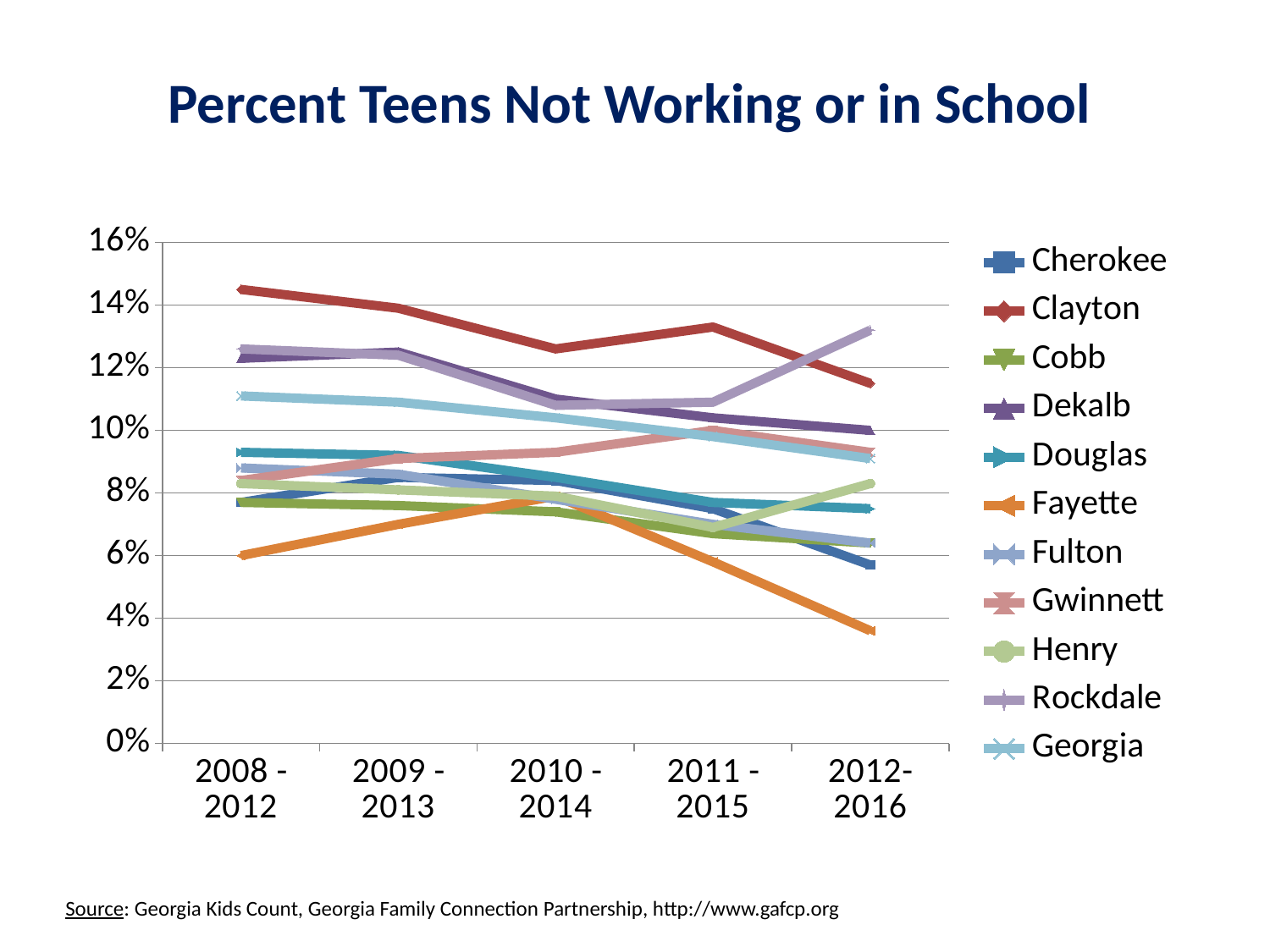
Which series has the lowest value in 2008 - 2012? Fayette How many series does the legend list? 11 Is the value for Clayton in 2008 - 2012 greater or less than 14%? greater Which series has the highest value in 2012-2016? Rockdale How many time periods are shown on the x axis? 5 Is the value for Fayette in 2012-2016 greater or less than 4%? less What kind of chart is shown on the slide? line chart Is the value for Georgia in 2008 - 2012 greater or less than 10%? greater In 2012-2016, which is larger, Rockdale or Clayton? Rockdale Which series has the lowest value in 2012-2016? Fayette Does the Georgia line rise or fall from 2008 - 2012 to 2012-2016? fall Which county has the highest percent of teens not working or in school in 2008 - 2012? Clayton